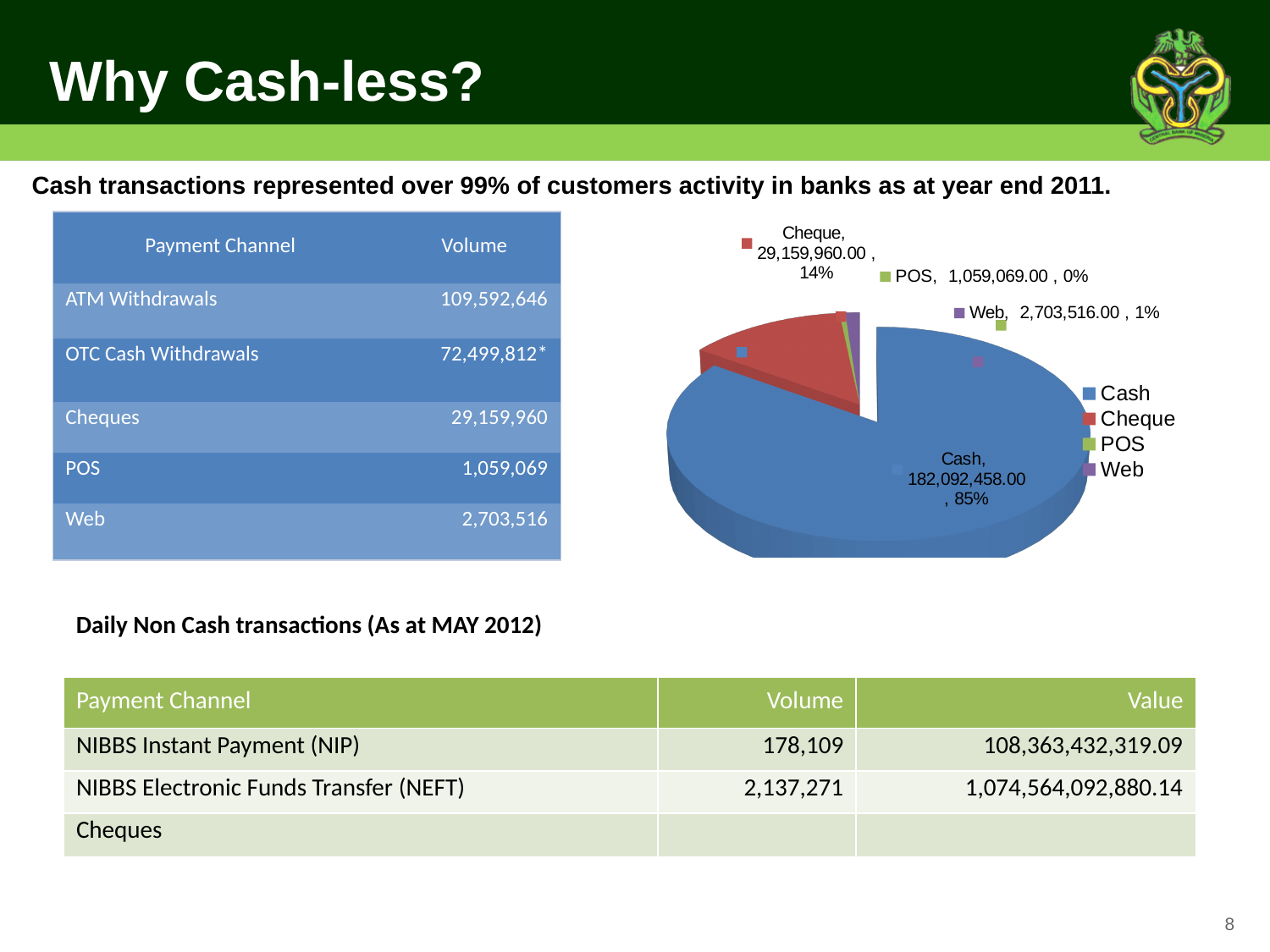
What percentage share of the pie chart does Cheque represent? 14% How many entries does the pie chart's legend list? 4 What value is shown for POS in the pie chart? 1,059,069.00 What value is shown for Web in the pie chart? 2,703,516.00 How many slices does the pie chart have? 4 What value is shown for Cheque in the pie chart? 29,159,960.00 Which category has the largest slice in the pie chart? Cash In the pie chart, which is larger, Web or POS? Web What kind of chart is shown on the slide? Pie chart What percentage share of the pie chart does Cash represent? 85% Which category has the smallest slice in the pie chart? POS What value is shown for Cash in the pie chart? 182,092,458.00